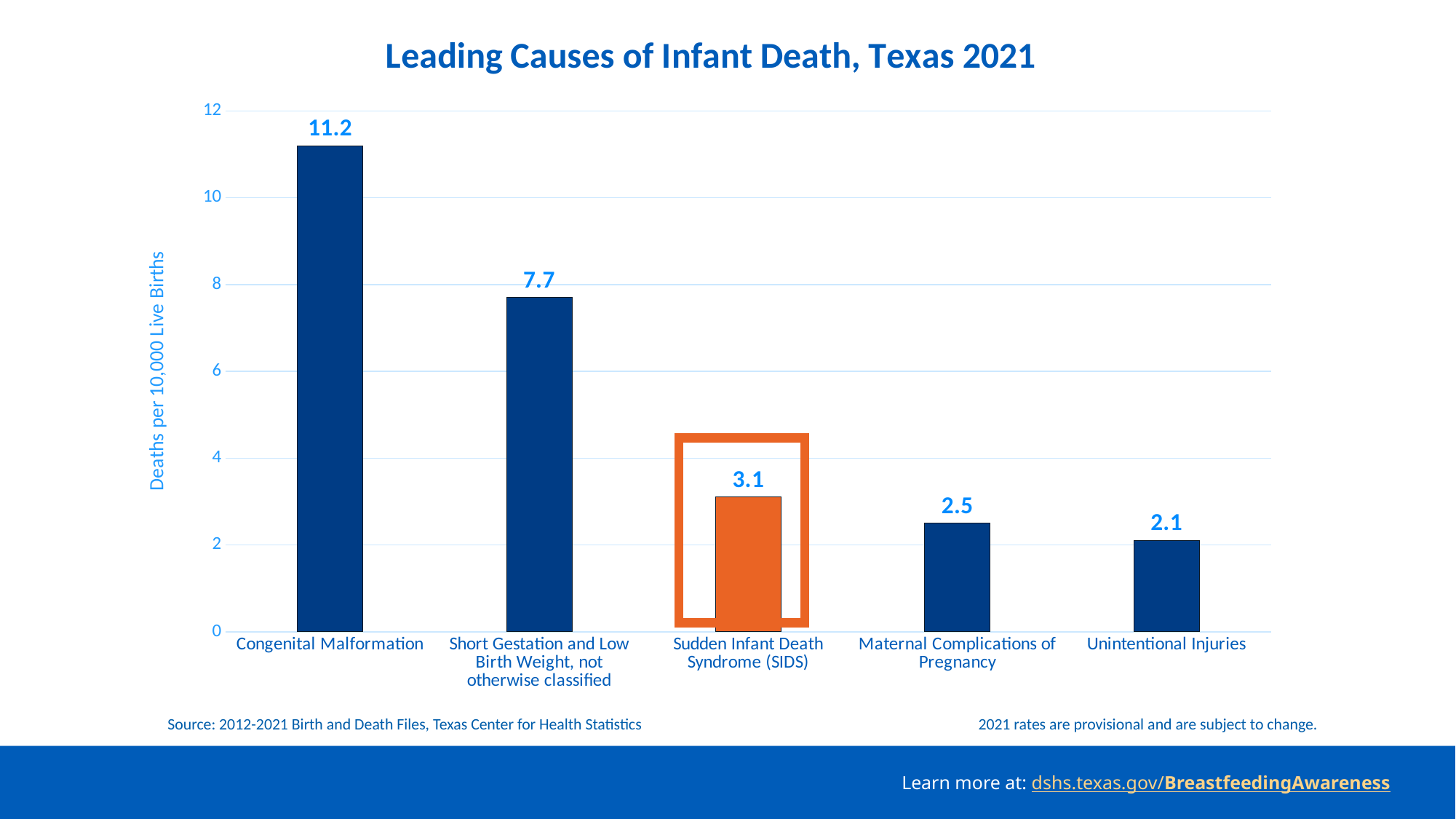
What is the value for Unintentional Injuries? 2.1 What is the difference between the values for Maternal Complications of Pregnancy and Unintentional Injuries? 0.4 How many causes of infant death are shown in the chart? 5 What is the value for Sudden Infant Death Syndrome (SIDS)? 3.1 What is the value for Congenital Malformation? 11.2 Which cause has the lowest rate of infant death? Unintentional Injuries Which bar is highlighted in orange? Sudden Infant Death Syndrome (SIDS) What is the difference between the values for Congenital Malformation and Short Gestation and Low Birth Weight, not otherwise classified? 3.5 Which cause has the highest rate of infant death? Congenital Malformation Is the value for Short Gestation and Low Birth Weight, not otherwise classified greater or less than 8? less Which is larger, the value for Sudden Infant Death Syndrome (SIDS) or the value for Maternal Complications of Pregnancy? Sudden Infant Death Syndrome (SIDS) What kind of chart is shown on the slide? Bar chart